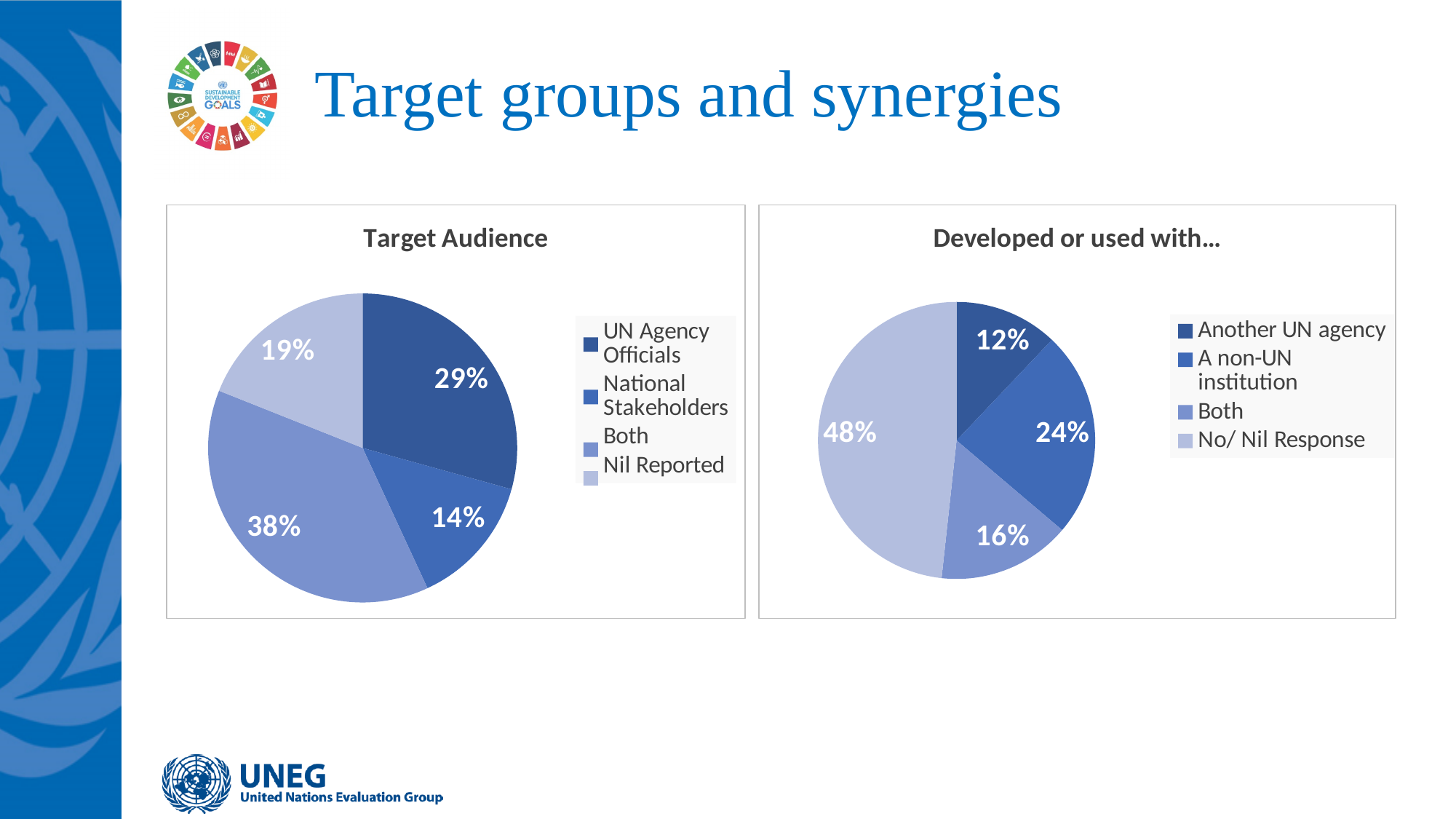
In the 'Target Audience' chart, which category has the largest slice? Both In the 'Developed or used with...' chart, which category has the smallest slice? Another UN agency In the 'Developed or used with...' chart, what share is labelled for A non-UN institution? 24% What type of chart is the 'Developed or used with...' chart? Pie chart How many categories does the legend of the 'Target Audience' chart list? 4 In the 'Target Audience' chart, what share is labelled for UN Agency Officials? 29% In the 'Developed or used with...' chart, which is larger: the share for Both or the share for A non-UN institution? A non-UN institution In the 'Developed or used with...' chart, what is the difference between the shares for No/ Nil Response and Another UN agency? 36% In the 'Target Audience' chart, which category has the smallest slice? National Stakeholders In the 'Target Audience' chart, what share is labelled for Both? 38% In the 'Developed or used with...' chart, what share is labelled for No/ Nil Response? 48% In the 'Target Audience' chart, what is the difference between the shares for Both and Nil Reported? 19%